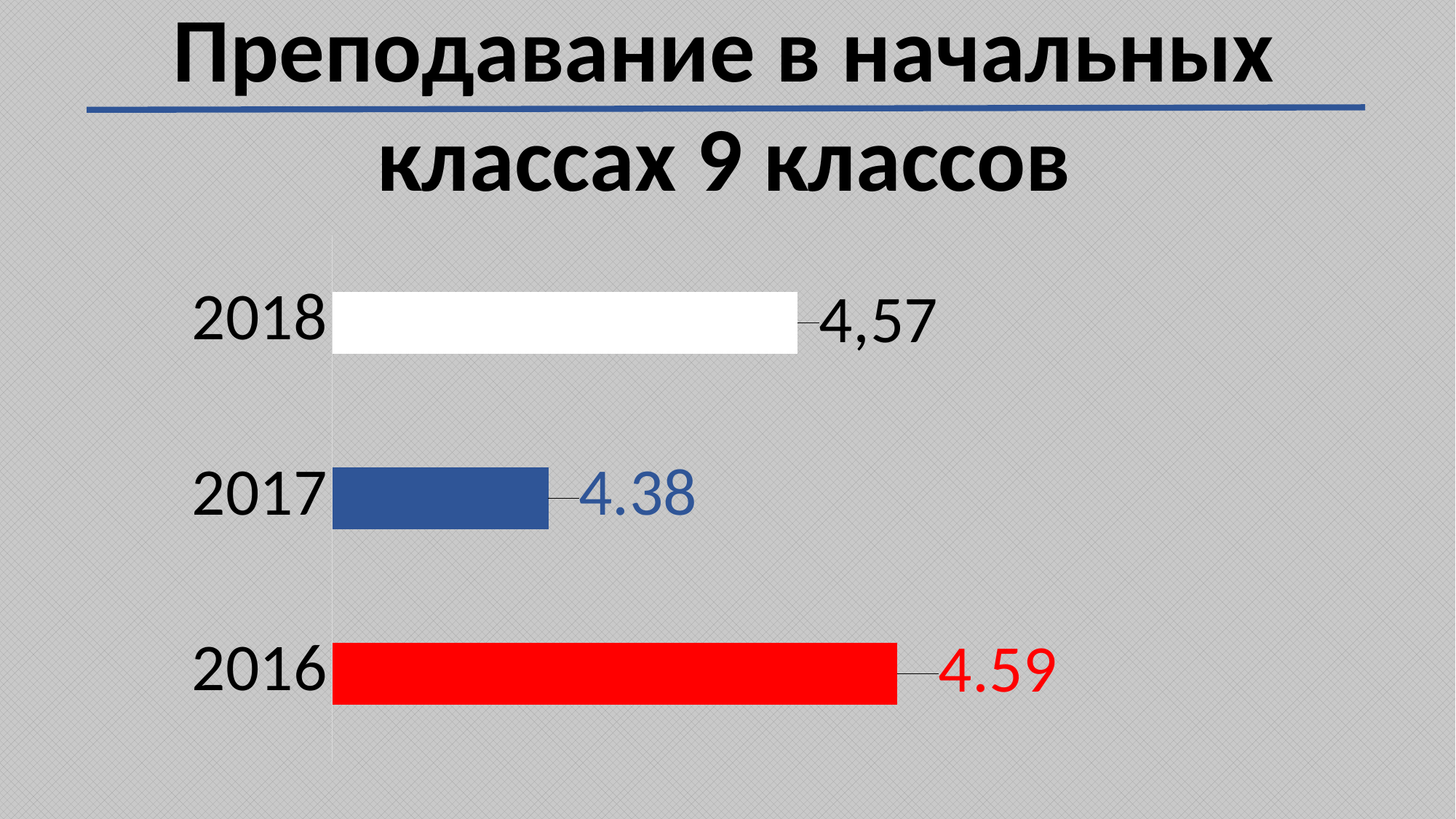
Which year has the highest value? 2016 What is the difference between the values for 2016 and 2017? 0.21 Did the value rise or fall from 2017 to 2018? Rise What kind of chart is shown on the slide? Bar chart What is the value shown for 2018? 4,57 What is the value shown for 2017? 4.38 What is the title of the slide? Преподавание в начальных классах 9 классов Which is larger, the value for 2017 or the value for 2018? 2018 How many years are shown in the chart? 3 Which year has the lowest value? 2017 What is the value shown for 2016? 4.59 What colour is the bar for 2016? Red